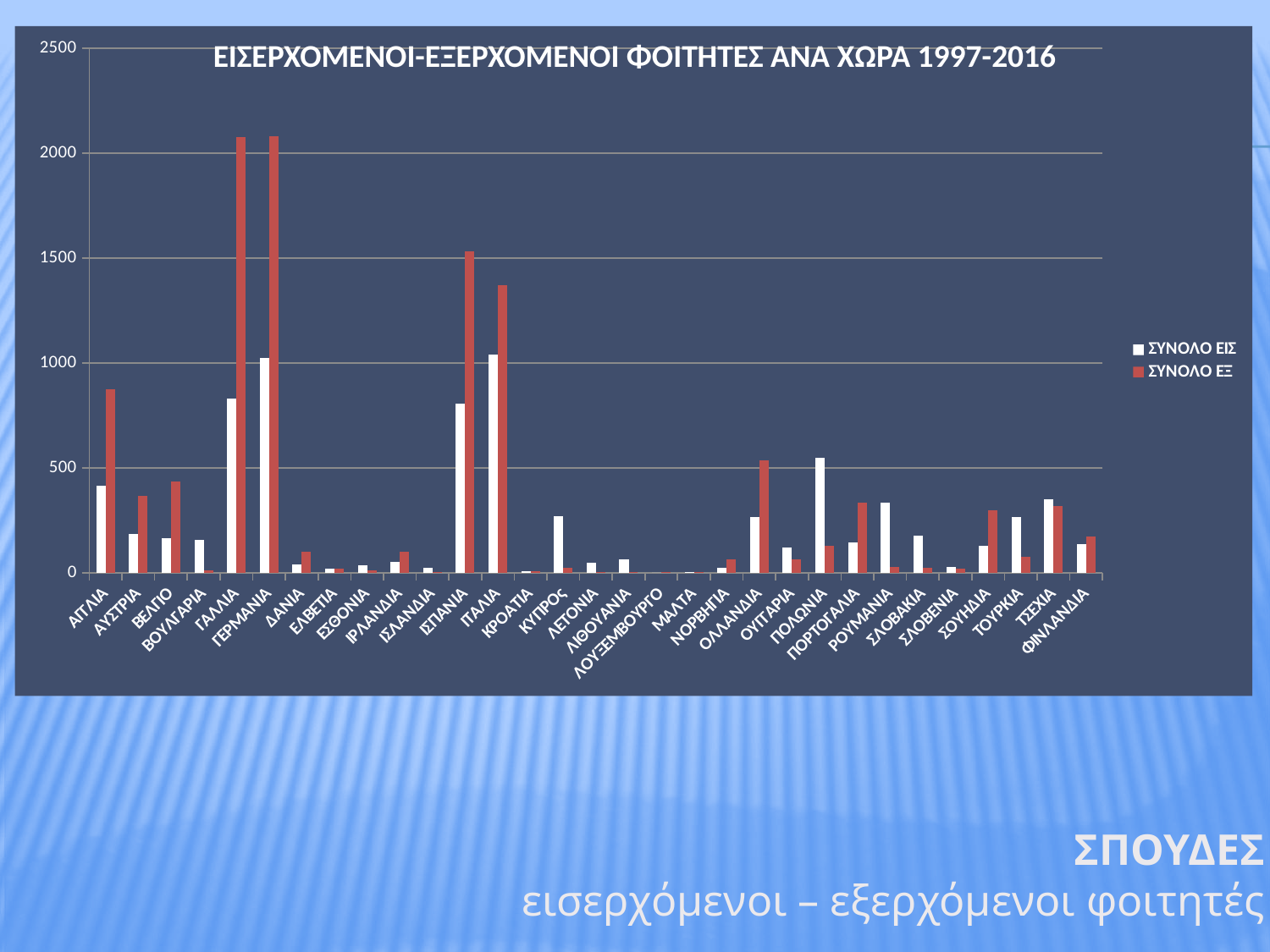
For ΑΓΓΛΙΑ, which is larger: ΣΥΝΟΛΟ ΕΙΣ or ΣΥΝΟΛΟ ΕΞ? ΣΥΝΟΛΟ ΕΞ Is the ΣΥΝΟΛΟ ΕΞ value for ΙΤΑΛΙΑ greater or less than 1500? less Is the ΣΥΝΟΛΟ ΕΞ value for ΑΓΓΛΙΑ greater or less than 500? greater Is the ΣΥΝΟΛΟ ΕΙΣ value for ΚΥΠΡΟΣ greater or less than 500? less How many countries are shown on the x axis of the chart? 31 For ΠΟΛΩΝΙΑ, which is larger: ΣΥΝΟΛΟ ΕΙΣ or ΣΥΝΟΛΟ ΕΞ? ΣΥΝΟΛΟ ΕΙΣ Which colour represents the ΣΥΝΟΛΟ ΕΞ series? Red Which country has the larger ΣΥΝΟΛΟ ΕΙΣ value: ΙΣΠΑΝΙΑ or ΙΤΑΛΙΑ? ΙΤΑΛΙΑ What is the title of the chart? ΕΙΣΕΡΧΟΜΕΝΟΙ-ΕΞΕΡΧΟΜΕΝΟΙ ΦΟΙΤΗΤΕΣ ΑΝΑ ΧΩΡΑ 1997-2016 What type of chart is shown on the slide? Bar chart How many series does the legend list? 2